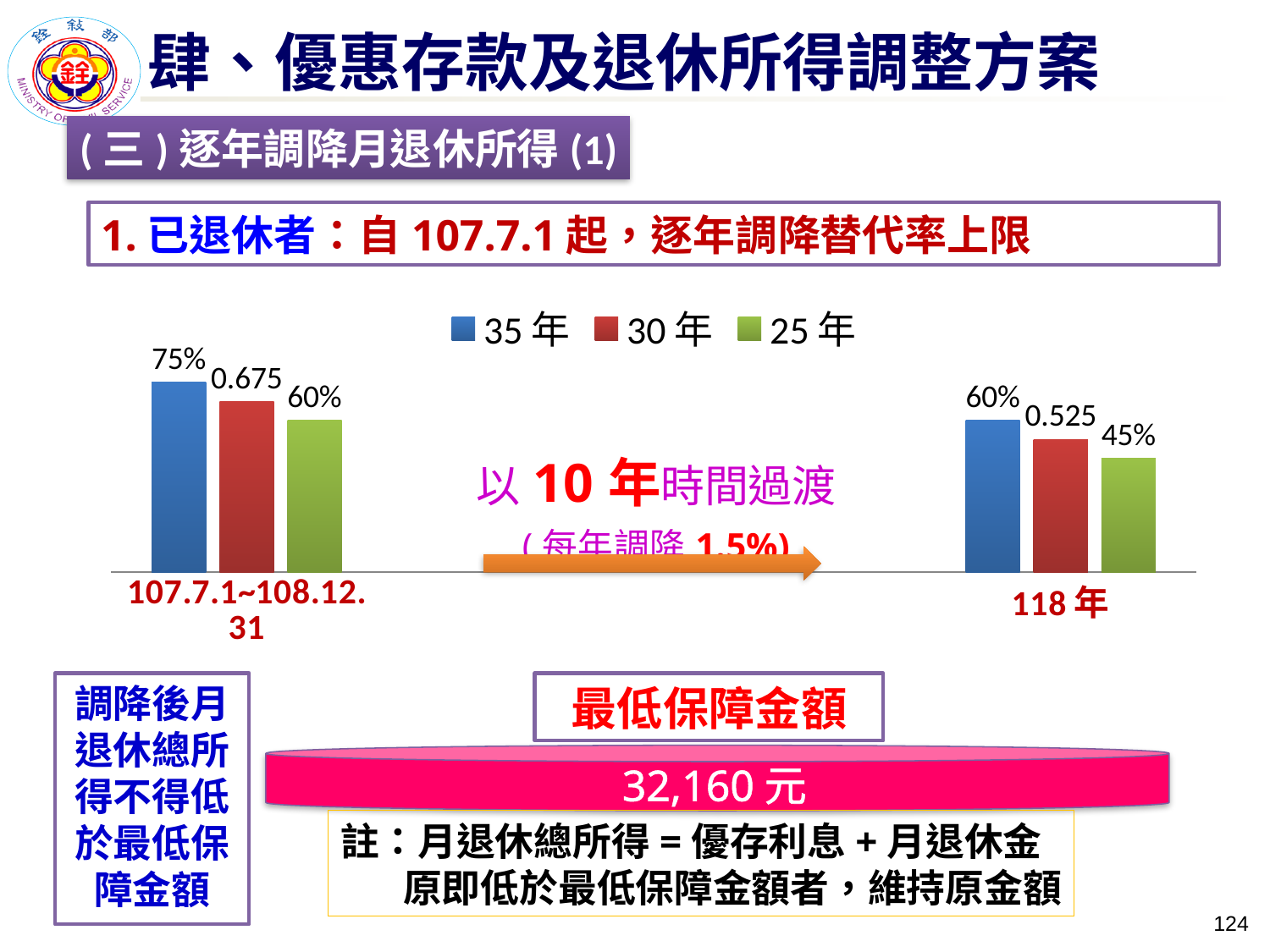
What kind of chart is shown on the slide? Bar chart What is the difference between the 35 年 and 25 年 values in the 118 年 category? 15% What is the value for the 30 年 series in the 118 年 category? 0.525 Is the 25 年 value larger in the 107.7.1~108.12.31 category or in the 118 年 category? 107.7.1~108.12.31 What is the value for the 30 年 series in the 107.7.1~108.12.31 category? 0.675 Which series has the lowest value in the 107.7.1~108.12.31 category? 25 年 What is the value for the 35 年 series in the 107.7.1~108.12.31 category? 75% What is the difference between the 35 年 value in 107.7.1~108.12.31 and the 35 年 value in 118 年? 15% What is the value for the 25 年 series in the 118 年 category? 45% Which series has the highest value in the 118 年 category? 35 年 How many series does the chart legend list? 3 How many categories are shown on the x axis of the chart? 2